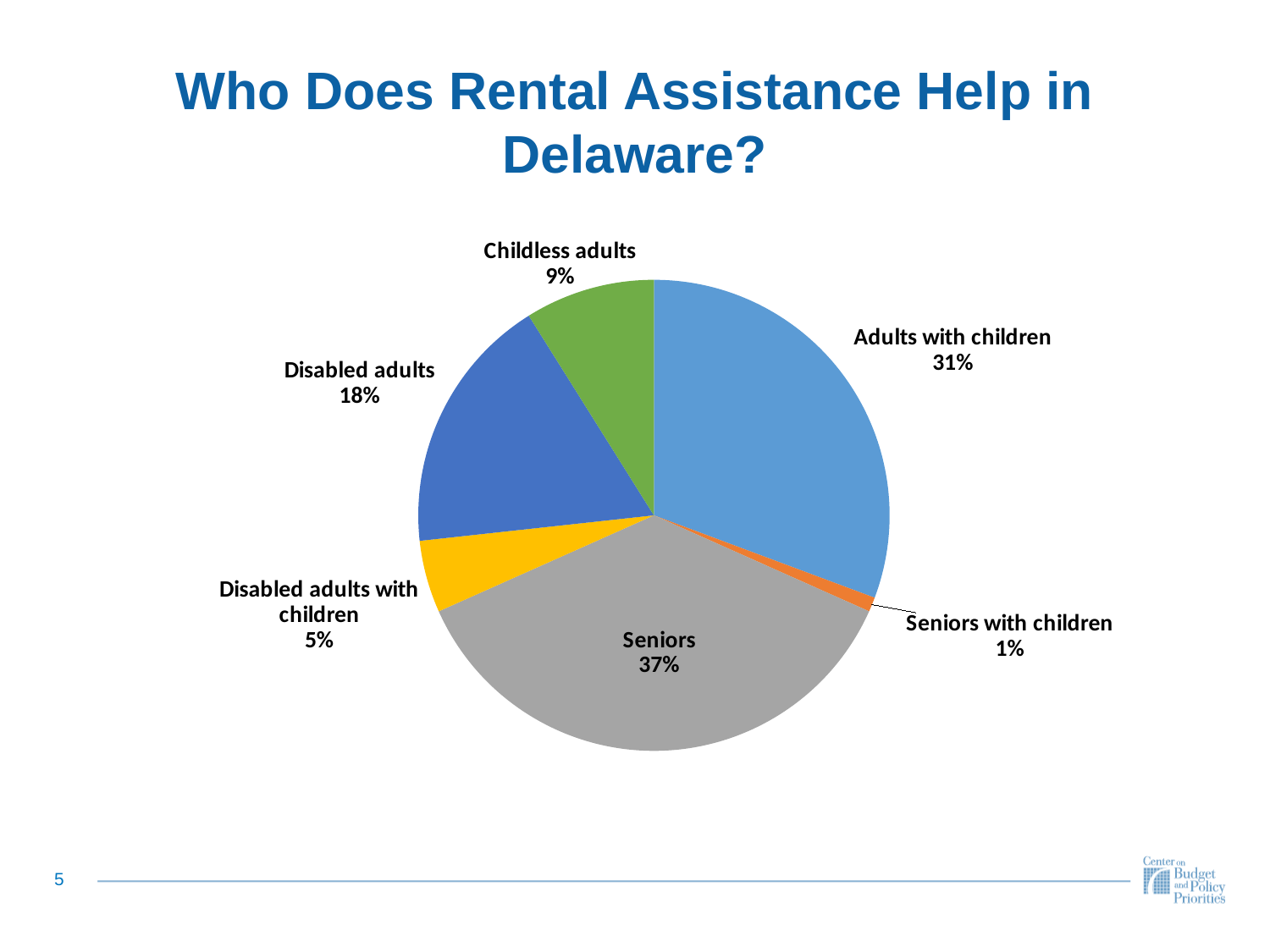
What kind of chart is shown on the slide? Pie chart Which category has the largest slice of the pie? Seniors What share of the pie is Adults with children? 31% What is the title of the slide? Who Does Rental Assistance Help in Delaware? What share of the pie is Seniors with children? 1% Which is larger, Disabled adults or Childless adults? Disabled adults What is the difference in percentage points between Seniors and Adults with children? 6 What share of the pie is Childless adults? 9% How many categories are shown in the pie chart? 6 What share of the pie is Seniors? 37% Which category has the smallest slice of the pie? Seniors with children What share of the pie is Disabled adults? 18%